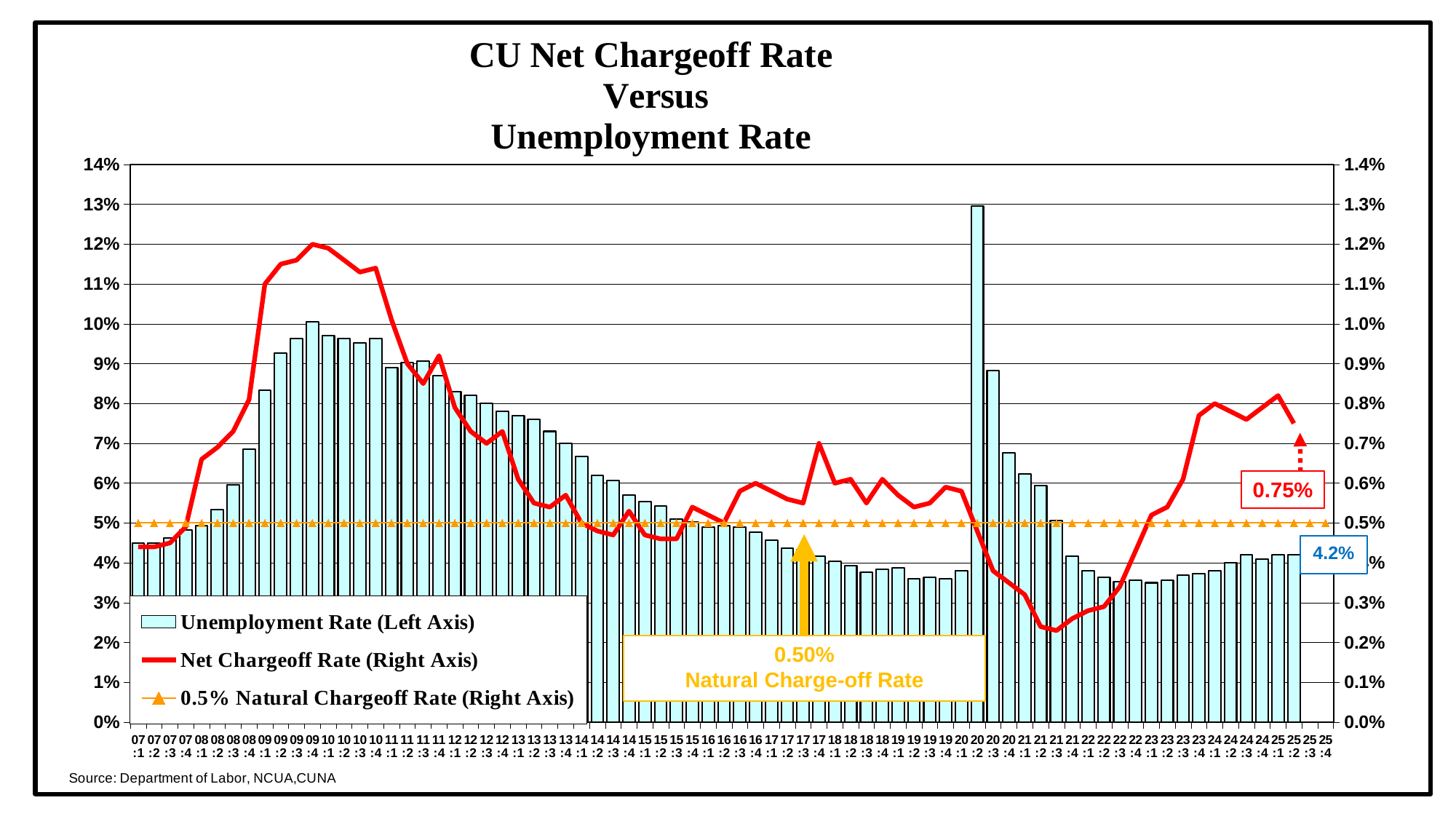
How many series does the legend list? 3 In which quarter is the Unemployment Rate bar highest? 20:2 Is the Unemployment Rate for 20:2 greater or less than 12%? greater What value is labelled for the most recent Unemployment Rate bar? 4.2% What is the title of the chart? CU Net Chargeoff Rate Versus Unemployment Rate Does the Net Chargeoff Rate rise or fall from 21:3 to 24:1? rise What kind of chart is this? Combination bar and line chart Is the Net Chargeoff Rate for 21:3 greater or less than 0.3%? less What is the Natural Charge-off Rate shown by the orange triangle line? 0.50% What value is labelled for the most recent Net Chargeoff Rate at the end of the red line? 0.75% Which is larger, the Net Chargeoff Rate in 09:4 or in 17:4? 09:4 Is the Net Chargeoff Rate for 09:4 greater or less than 1.1%? greater